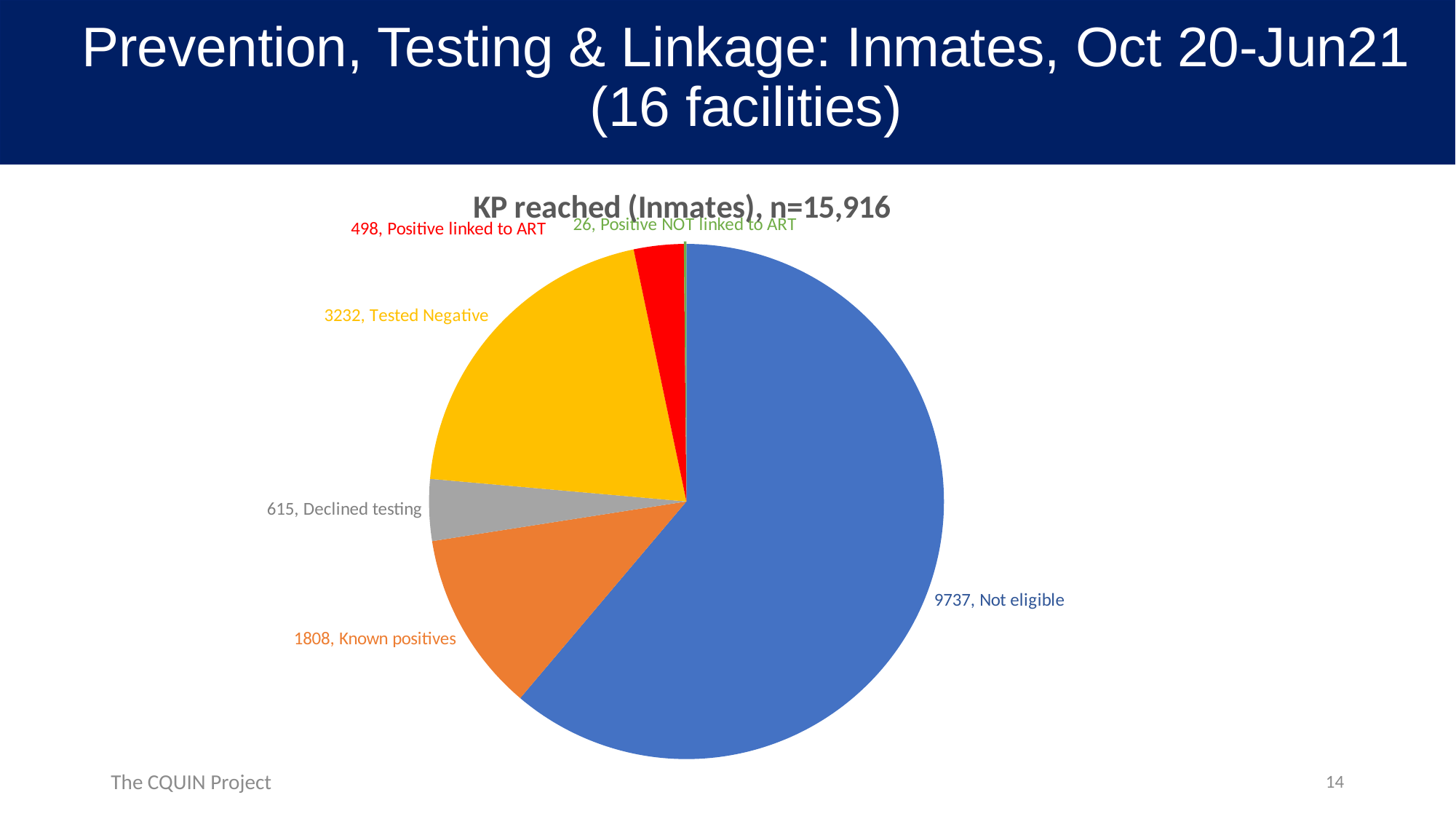
Which is larger, Known positives or Declined testing? Known positives What type of chart is shown on the slide? Pie chart What is the value for Not eligible? 9737 Which category has the largest slice of the pie? Not eligible What is the value for Declined testing? 615 What is the difference between Positive linked to ART and Positive NOT linked to ART? 472 What is the value for Positive NOT linked to ART? 26 What is the value for Tested Negative? 3232 What is the title of the chart? KP reached (Inmates), n=15,916 How many slices does the pie chart have? 6 What is the difference between the Not eligible value and the Tested Negative value? 6505 Which category has the smallest slice of the pie? Positive NOT linked to ART